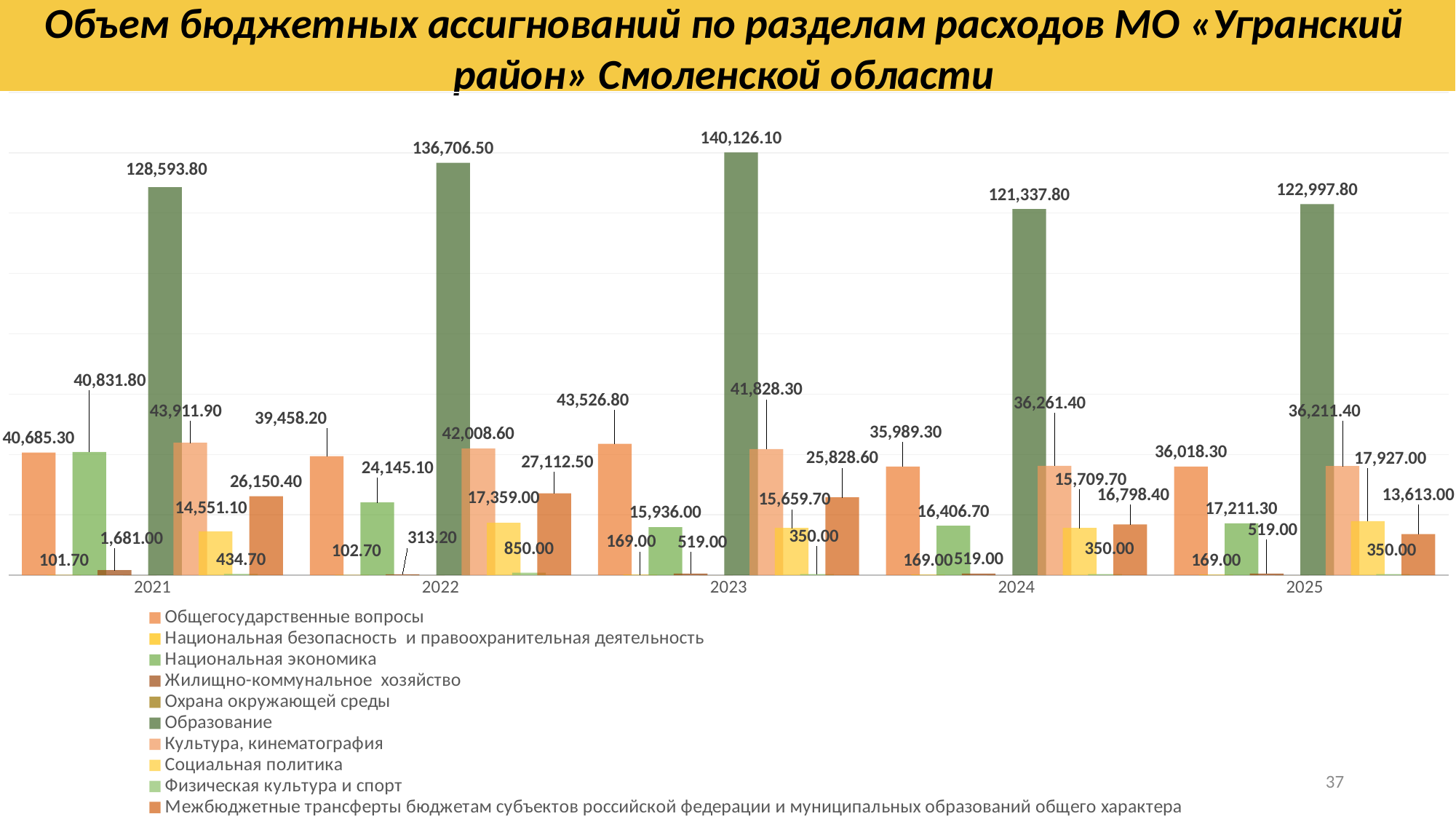
What is the value for Образование in 2023? 140,126.10 From 2021 to 2023, does the value for Образование rise or fall? Rise How many series does the legend list? 10 What is the value for Межбюджетные трансферты in 2022? 27,112.50 In which year is the value for Образование the highest? 2023 How many years are shown along the x axis? 5 In 2021, which is larger: Культура, кинематография or Общегосударственные вопросы? Культура, кинематография What is the value for Социальная политика in 2025? 17,927.00 In which year is the value for Образование the lowest? 2024 What type of chart is shown on the slide? Bar chart What is the difference between the Образование values for 2023 and 2022? 3,419.60 What is the difference between the Общегосударственные вопросы values for 2023 and 2024? 7,537.50